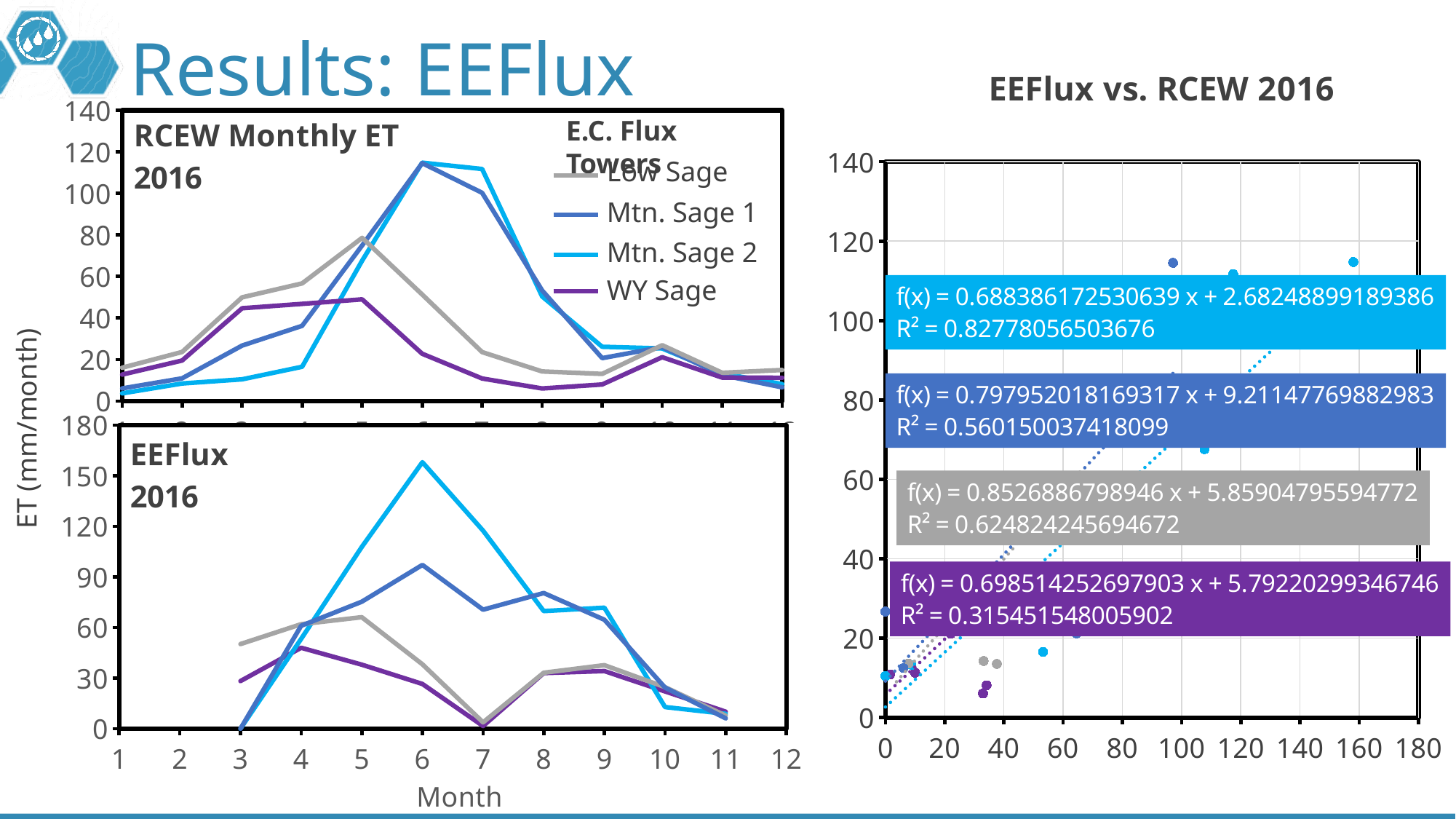
In the 'EEFlux 2016' chart, is the value for Mtn. Sage 2 at month 6 greater or less than 120? greater In the 'EEFlux vs. RCEW 2016' chart, what is the highest R² value shown? 0.82778056503676 What kind of chart is the 'EEFlux vs. RCEW 2016' chart? scatter plot In the 'RCEW Monthly ET 2016' chart, is the value for Mtn. Sage 2 at month 6 greater or less than 100? greater In the 'RCEW Monthly ET 2016' chart, which series has the lowest value at month 6? WY Sage In the 'RCEW Monthly ET 2016' chart, does the Mtn. Sage 2 line rise or fall from month 1 to month 6? rise How many months are shown on the x axis of the 'EEFlux 2016' chart? 12 What kind of chart is the 'RCEW Monthly ET 2016' chart? line chart In the 'EEFlux 2016' chart, which series reaches the highest peak value? Mtn. Sage 2 How many series does the legend of the 'RCEW Monthly ET 2016' chart list? 4 In the 'RCEW Monthly ET 2016' chart, which is larger at month 5: Low Sage or WY Sage? Low Sage In the 'RCEW Monthly ET 2016' chart, is the value for WY Sage at month 6 greater or less than 40? less